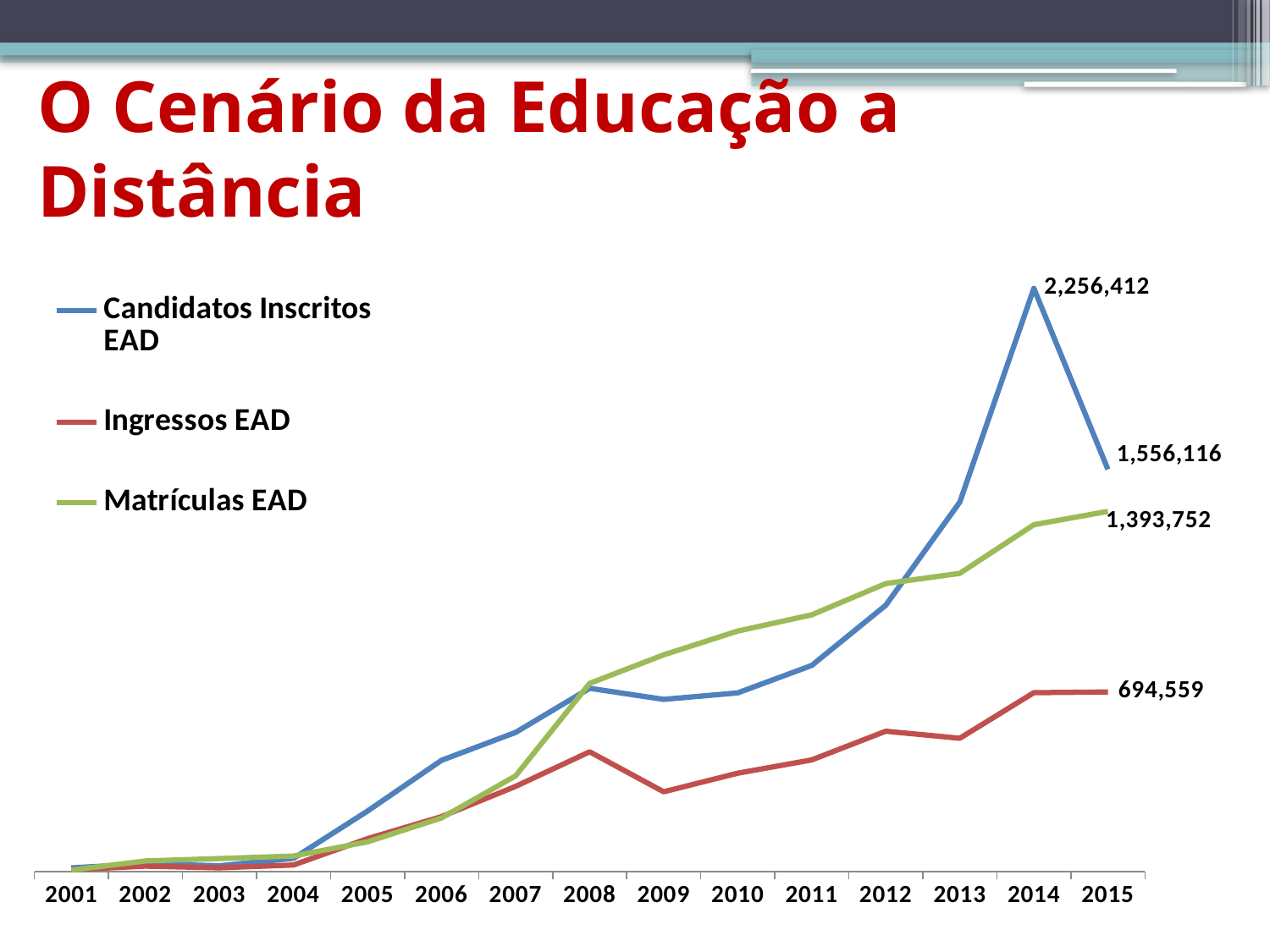
How many series does the legend list? 3 Which series has the lowest value in 2015? Ingressos EAD Does Candidatos Inscritos EAD rise or fall from 2014 to 2015? fall What is the difference between Candidatos Inscritos EAD and Matrículas EAD in 2015? 162,364 By how much did Candidatos Inscritos EAD fall from 2014 to 2015? 700,296 Which series has the highest value in 2015? Candidatos Inscritos EAD How many years are shown along the x axis? 15 What is the value of Candidatos Inscritos EAD in 2015? 1,556,116 What is the value of Candidatos Inscritos EAD in 2014? 2,256,412 What is the value of Matrículas EAD in 2015? 1,393,752 What kind of chart is shown on the slide? line chart What is the value of Ingressos EAD in 2015? 694,559